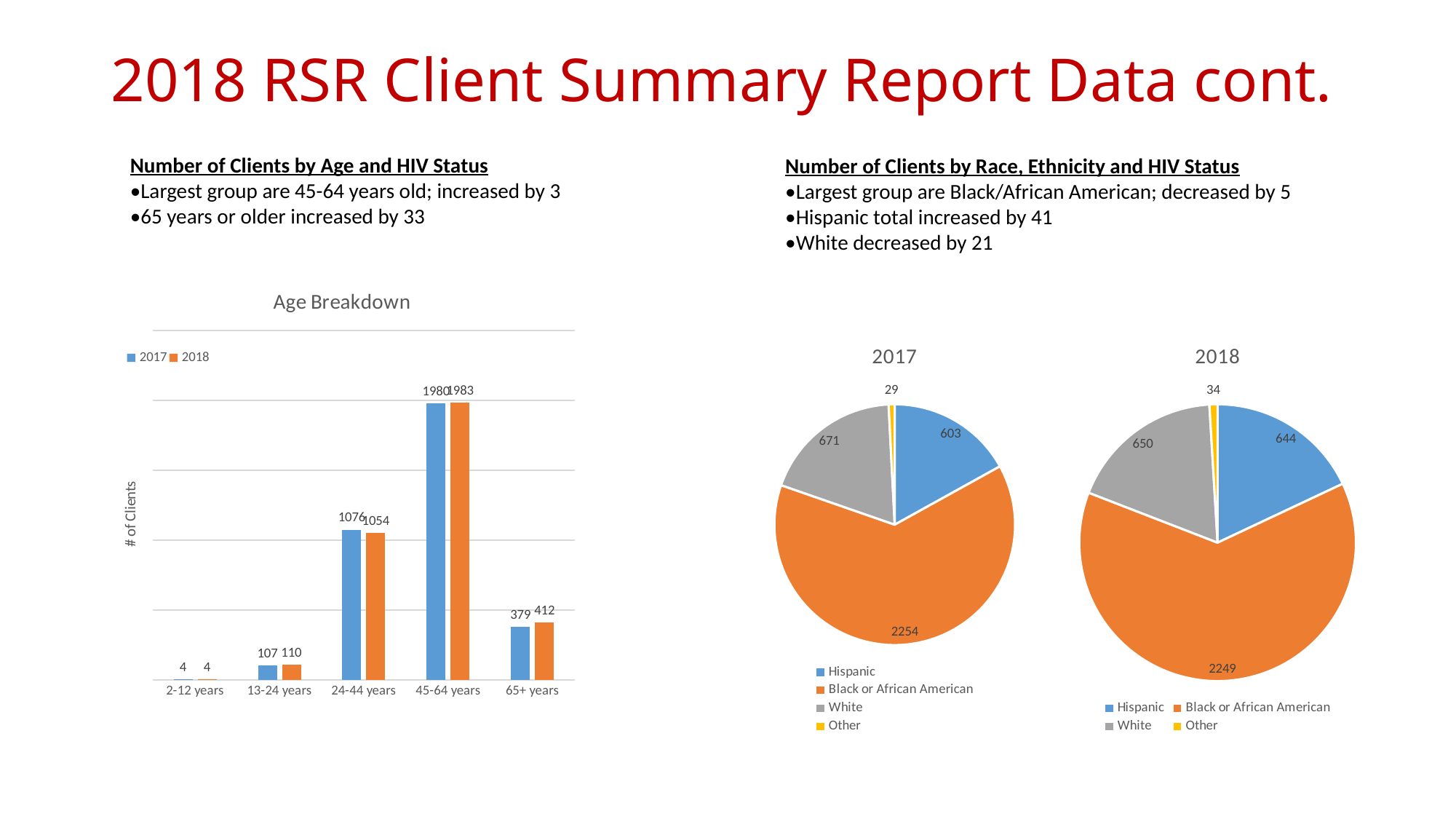
What is the difference between the Hispanic value in the 2018 pie chart and the Hispanic value in the 2017 pie chart? 41 In the 2017 pie chart, what is the value for White? 671 In the Age Breakdown chart, which age group has the highest value for 2018? 45-64 years How many series does the legend of the Age Breakdown chart list? 2 How many age categories are shown on the x axis of the Age Breakdown chart? 5 In the Age Breakdown chart, by how much did the 65+ years value increase from 2017 to 2018? 33 In the 2018 pie chart, which category has the smallest slice? Other In the Age Breakdown chart, what is the 2018 value for 65+ years? 412 In the 2018 pie chart, what is the value for Hispanic? 644 In the Age Breakdown chart, for 24-44 years, which year has the larger value, 2017 or 2018? 2017 What kind of chart is the Age Breakdown chart? bar chart In the Age Breakdown chart, what is the 2017 value for 24-44 years? 1076